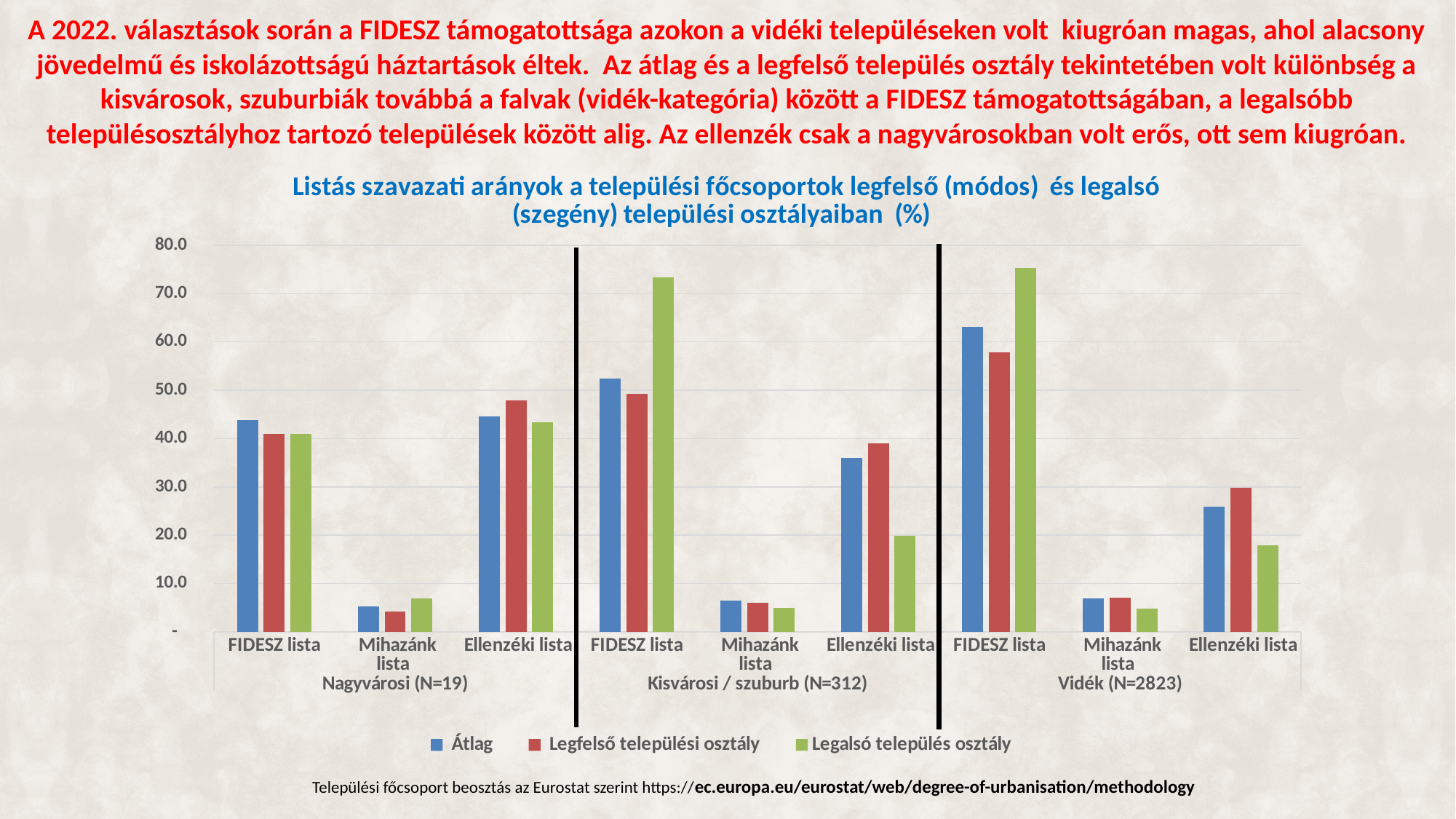
Is the value for Legalsó település osztály for FIDESZ lista in the Vidék (N=2823) group greater or less than 70? greater How many settlement main groups (Nagyvárosi, Kisvárosi / szuburb, Vidék) are shown on the x axis? 3 In the Vidék (N=2823) group, which series has the highest value for FIDESZ lista? Legalsó település osztály Is the value for Legalsó település osztály for FIDESZ lista in the Kisvárosi / szuburb (N=312) group greater or less than 70? greater Is the value for Átlag for FIDESZ lista in the Vidék (N=2823) group greater or less than 60? greater What colour represents the Átlag series in the legend? blue In the Vidék (N=2823) group, which series has the lowest value for Mihazánk lista? Legalsó település osztály In the Nagyvárosi (N=19) group, which is larger for Ellenzéki lista: Átlag or Legfelső települési osztály? Legfelső települési osztály In the Kisvárosi / szuburb (N=312) group, which is larger for Ellenzéki lista: Átlag or Legalsó település osztály? Átlag What kind of chart is shown on the slide? bar chart How many series does the legend list? 3